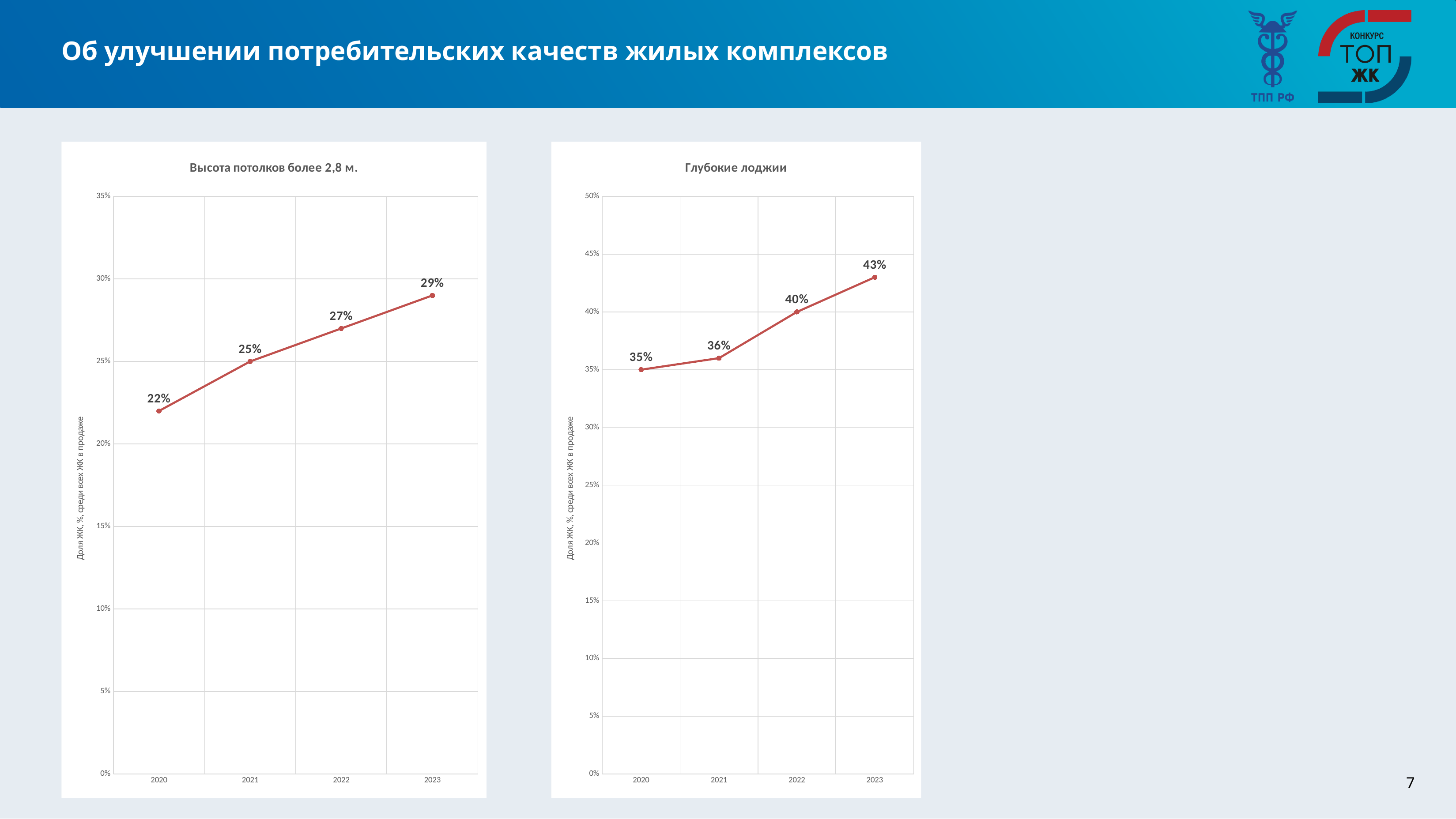
In the chart titled "Глубокие лоджии", what is the difference between the 2023 and 2020 values? 8% In the chart titled "Высота потолков более 2,8 м.", what is the value for 2020? 22% In the chart titled "Высота потолков более 2,8 м.", what is the value for 2023? 29% In the chart titled "Глубокие лоджии", is the value for 2022 greater or less than 35%? greater What kind of chart is the chart titled "Глубокие лоджии"? line chart In the chart titled "Высота потолков более 2,8 м.", which year has the lowest value? 2020 In the chart titled "Глубокие лоджии", what is the value for 2021? 36% In the chart titled "Глубокие лоджии", which year has the highest value? 2023 In the chart titled "Глубокие лоджии", what is the value for 2022? 40% How many data points are plotted in the chart titled "Высота потолков более 2,8 м."? 4 In the chart titled "Высота потолков более 2,8 м.", do the values rise or fall from 2020 to 2023? rise In the chart titled "Высота потолков более 2,8 м.", what is the difference between the 2023 and 2020 values? 7%